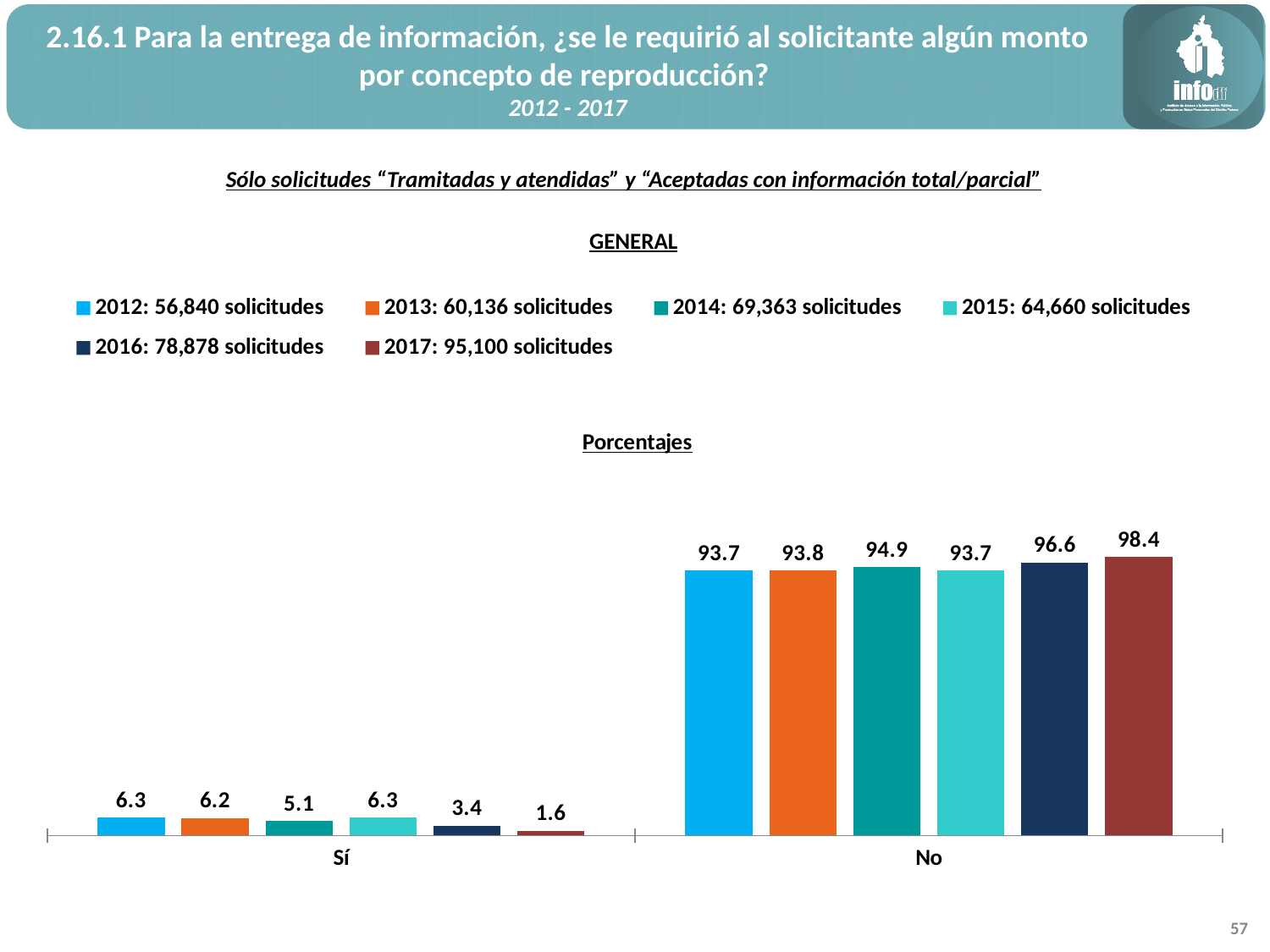
What is the value for 2017 in the "Sí" category? 1.6 How many categories are shown on the x axis? 2 Do the values in the "Sí" category rise or fall from 2015 to 2017? Fall What is the difference between the 2017 and 2012 values in the "No" category? 4.7 Which year has the highest value in the "No" category? 2017 What is the value for 2016 in the "Sí" category? 3.4 According to the legend, how many solicitudes were there in 2017? 95,100 solicitudes Which is larger in the "Sí" category: the value for 2013 or the value for 2016? 2013 How many series does the legend list? 6 Which year has the lowest value in the "Sí" category? 2017 What is the value for 2014 in the "No" category? 94.9 What kind of chart is shown on the slide? Bar chart